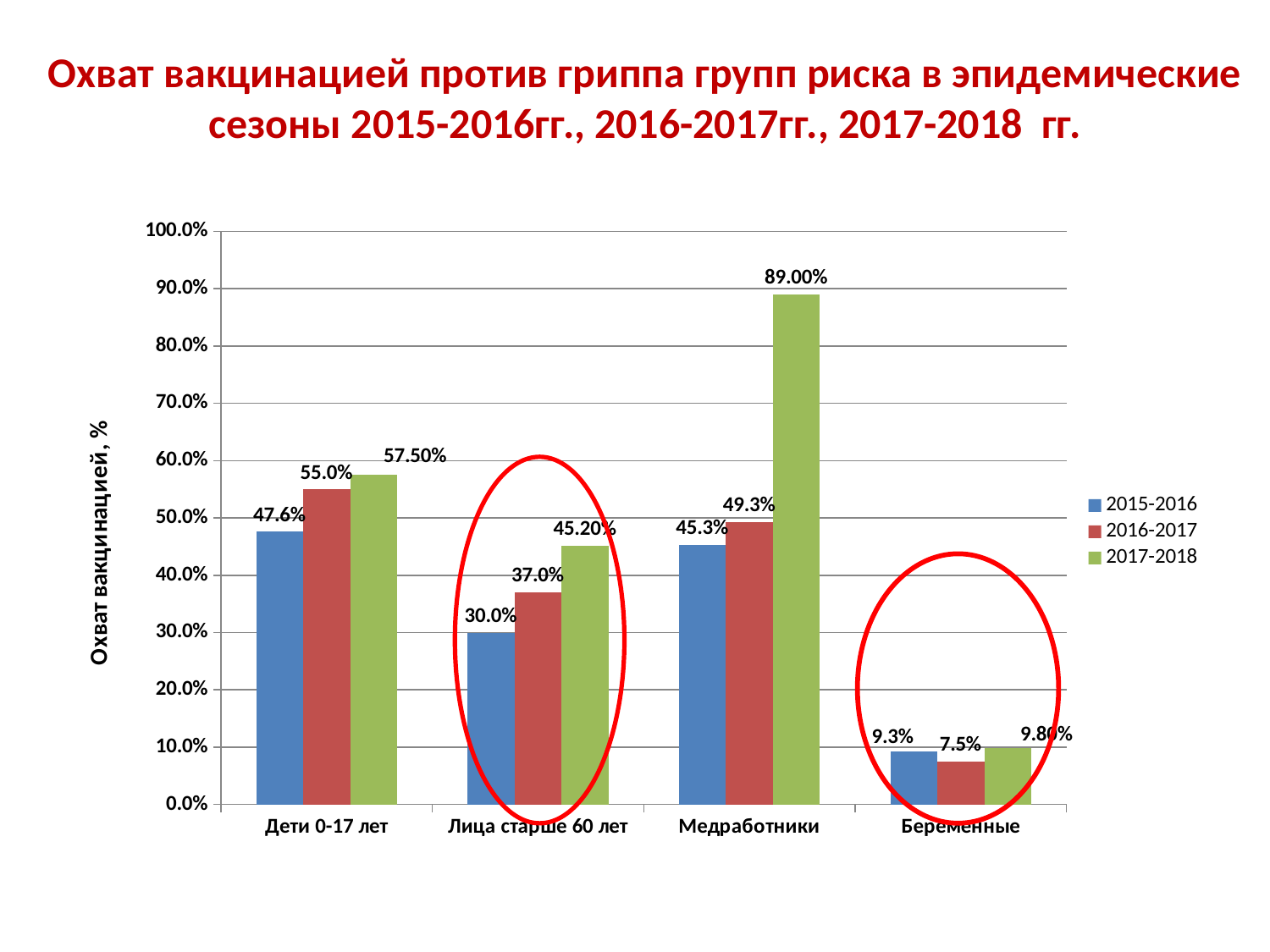
What is the value for Медработники in the 2017-2018 series? 89.00% Which category has the lowest value in the 2015-2016 series? Беременные Which is larger for Дети 0-17 лет: the 2015-2016 value or the 2016-2017 value? 2016-2017 Which category has the highest value in the 2017-2018 series? Медработники What is the value for Лица старше 60 лет in the 2015-2016 series? 30.0% What is the difference between the 2017-2018 and 2016-2017 values for Медработники? 39.7% What is the value for Беременные in the 2016-2017 series? 7.5% What is the label of the vertical axis? Охват вакцинацией, % How many categories are shown on the x axis? 4 Do the values for Лица старше 60 лет rise or fall from the 2015-2016 series to the 2017-2018 series? rise How many series does the legend list? 3 What type of chart is shown on the slide? bar chart